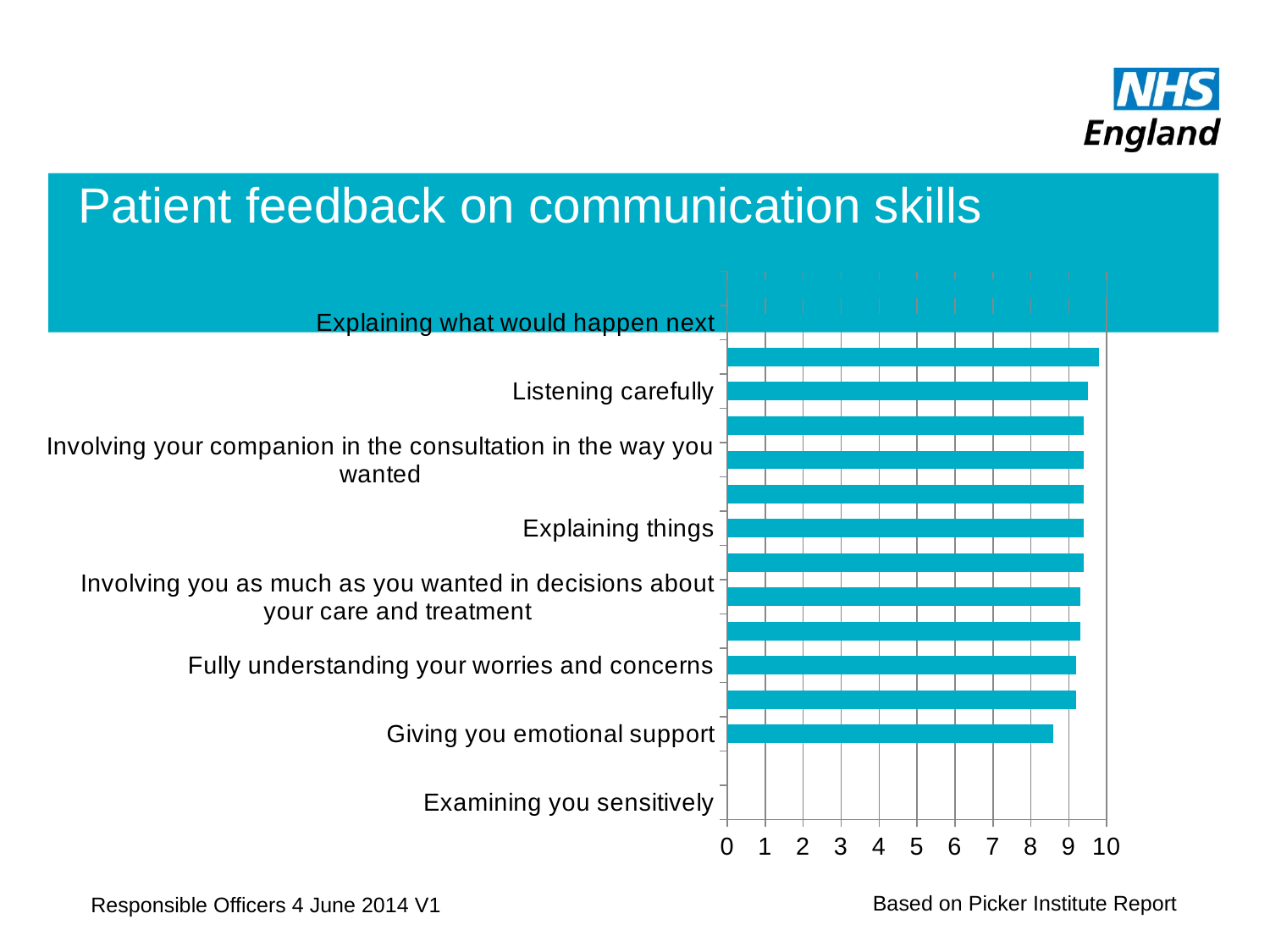
Are all the bars on the chart greater or less than 8? greater What is the highest value shown on the chart's horizontal axis? 10 Is any bar on the chart greater than 10? No What kind of chart is shown on the slide? Bar chart Which category label appears at the bottom of the chart's vertical axis? Examining you sensitively Is the longest bar on the chart greater or less than 9? greater How many category labels are listed on the chart's vertical axis? 8 What is the title of the slide containing the chart? Patient feedback on communication skills